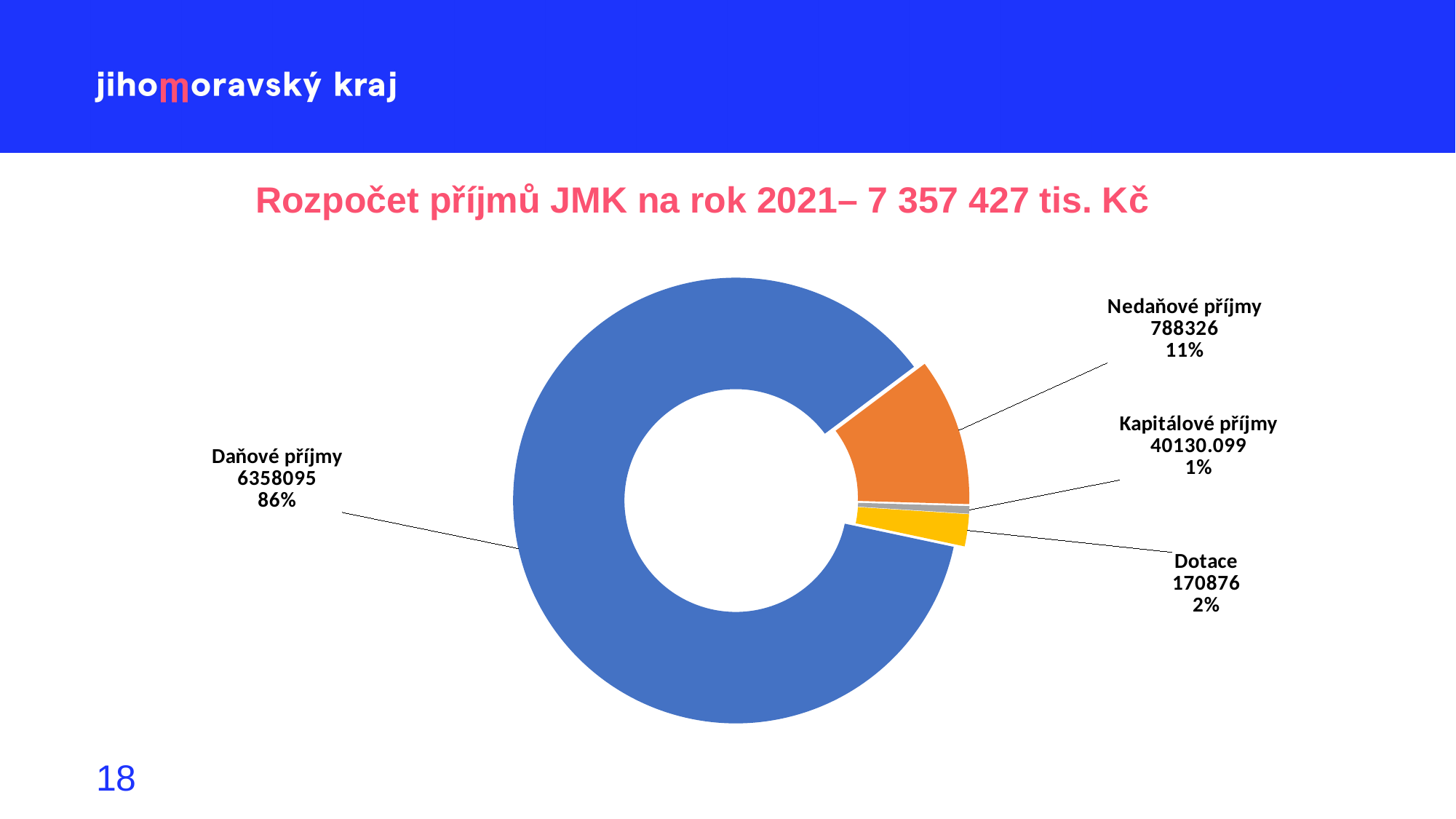
What is the value for Kapitálové příjmy? 40130.099 What share of the chart does Nedaňové příjmy represent? 11% Which category has the largest value? Daňové příjmy What is the value for Nedaňové příjmy? 788326 What kind of chart is shown on the slide? Doughnut chart Which category has the smallest value? Kapitálové příjmy What is the value for Daňové příjmy? 6358095 What is the difference between the values for Nedaňové příjmy and Dotace? 617450 How many categories are shown in the chart? 4 What share of the chart does Daňové příjmy represent? 86% What is the value for Dotace? 170876 Which is larger, Dotace or Kapitálové příjmy? Dotace